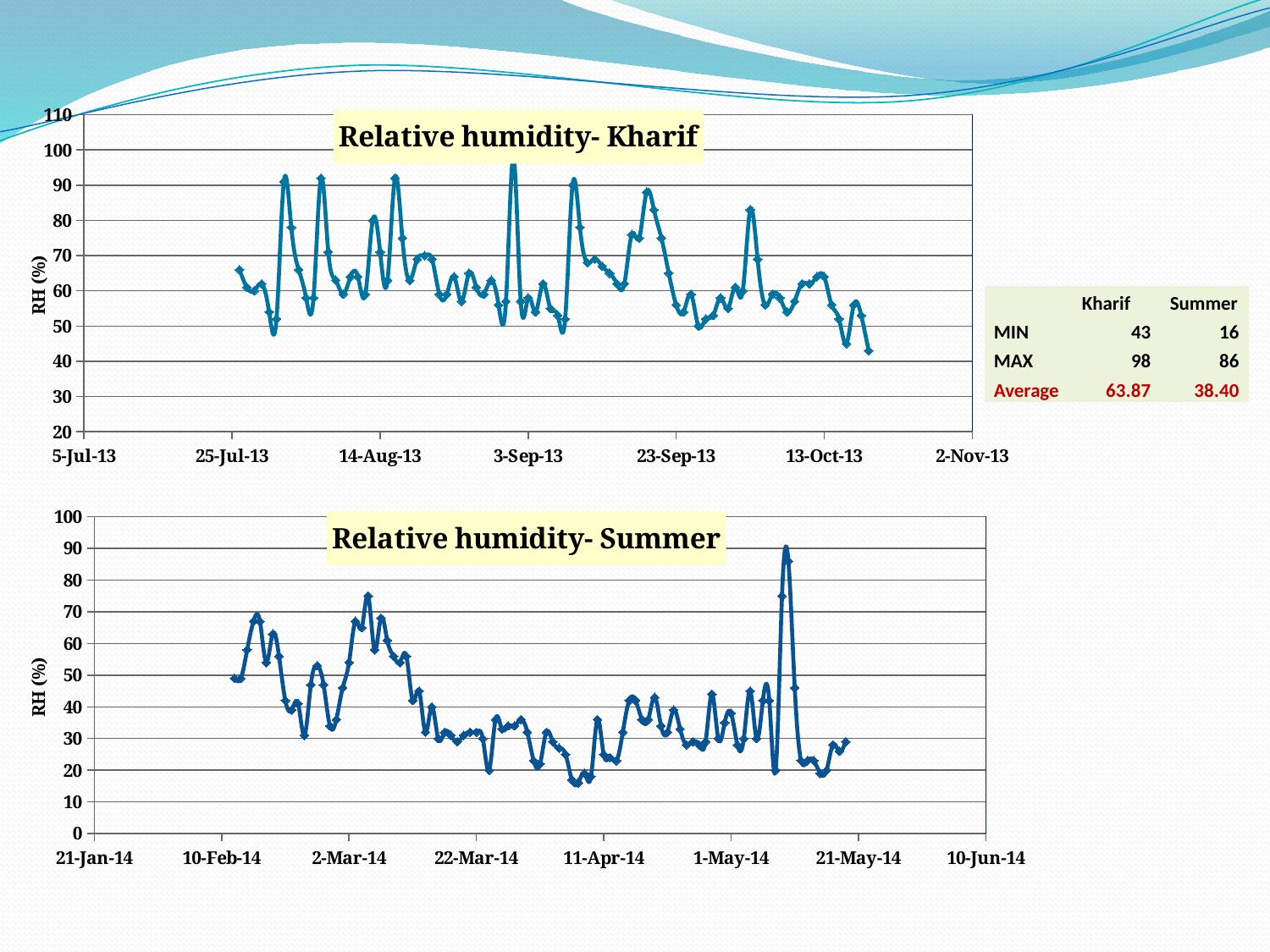
In the 'Relative humidity- Kharif' chart, is the lowest point greater or less than 50? less In the 'Relative humidity- Kharif' chart, is the highest peak greater or less than 90? greater According to the table next to the Kharif chart, what is the MIN relative humidity for Kharif? 43 What is the y-axis label on the 'Relative humidity- Summer' chart? RH (%) According to the table, what is the difference between the MAX relative humidity for Kharif and for Summer? 12 In the 'Relative humidity- Summer' chart, do the values generally rise or fall between 2-Mar-14 and 11-Apr-14? fall According to the table next to the Kharif chart, what is the Average relative humidity for Summer? 38.40 In the 'Relative humidity- Summer' chart, is the highest peak greater or less than 80? greater How many date labels are shown on the x axis of the 'Relative humidity- Summer' chart? 8 What kind of chart is the 'Relative humidity- Kharif' chart? line chart According to the table, which season has the higher MAX relative humidity, Kharif or Summer? Kharif